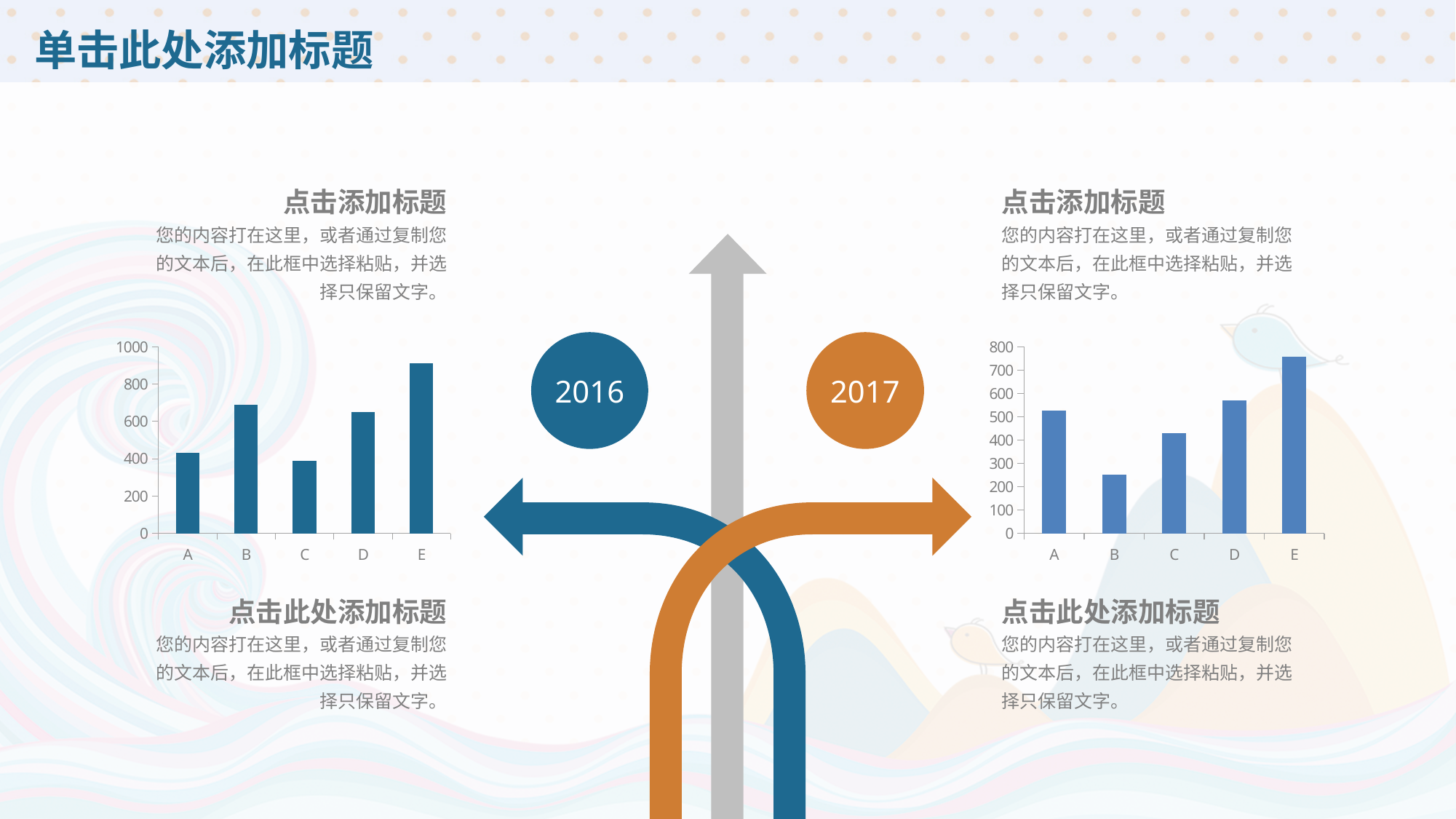
In the right chart, which category has the highest bar? E In the left chart, which category has the lowest bar? C In the left chart, is the value for A greater or less than 600? less In the left chart, is the value for E greater or less than 800? greater What kind of chart is the right chart (next to 2017)? bar chart In the right chart, which category has the lowest bar? B In the left chart, which is larger, the value for B or the value for D? B What is the highest value shown on the y axis of the right chart? 800 What kind of chart is the left chart (next to 2016)? bar chart In the left chart, which category has the highest bar? E In the right chart, is the value for D greater or less than 500? greater How many categories does the left chart show on its x axis? 5